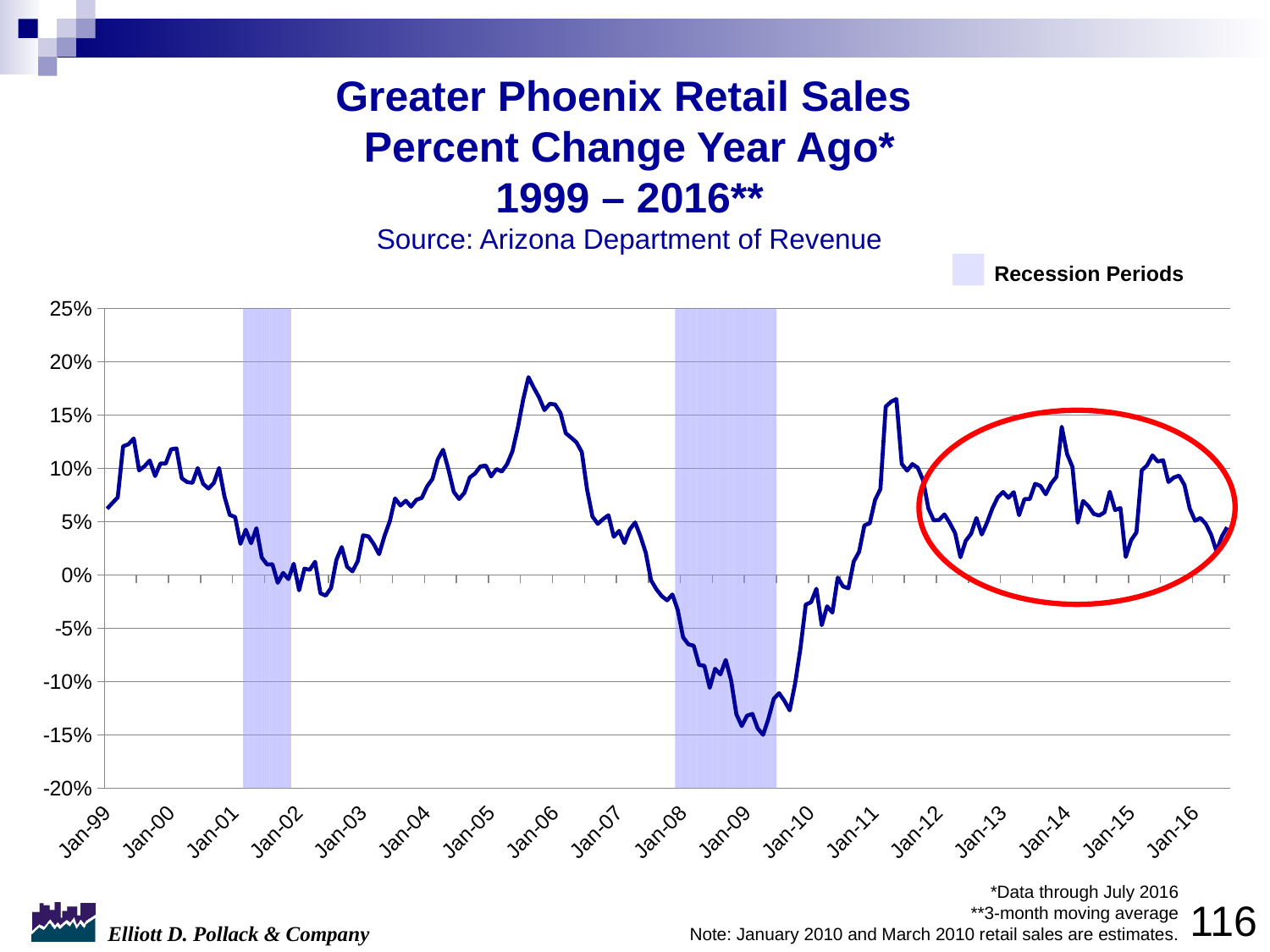
Is the peak value reached near Jan-06 greater or less than 15%? greater What kind of chart is shown on the slide? line chart Is the spike near Jan-14 greater or less than 10%? greater Around which year label does the line reach its lowest value? Jan-09 Is the value at Jan-13 greater or less than 5%? greater What do the shaded vertical bands on the chart represent, according to the legend? Recession Periods Do the values generally rise or fall between Jan-06 and Jan-09? fall How many year labels are shown along the x axis? 18 Which is lower, the trough near Jan-02 or the trough near Jan-09? Jan-09 What is the title of the chart? Greater Phoenix Retail Sales Percent Change Year Ago* 1999 – 2016** Around which year label does the line reach its highest value? Jan-06